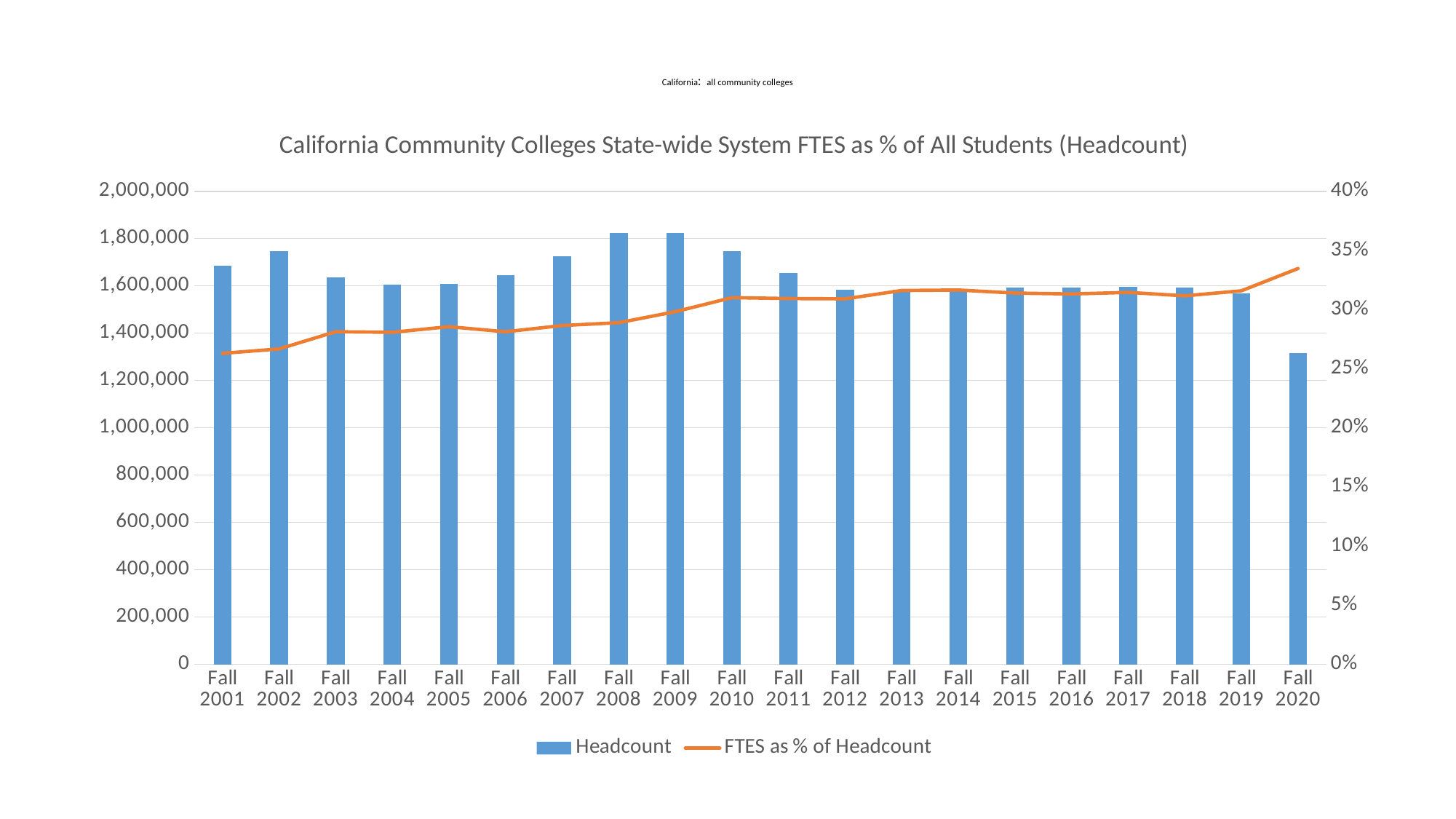
Is the Headcount for Fall 2020 greater or less than 1,400,000? less Is FTES as % of Headcount for Fall 2020 greater or less than 30%? greater Which has the larger Headcount, Fall 2002 or Fall 2003? Fall 2002 In which fall term is FTES as % of Headcount highest? Fall 2020 What kind of chart is this? Combination bar and line chart How many series does the legend list? 2 Which fall term has the lowest Headcount? Fall 2020 Does FTES as % of Headcount generally rise or fall from Fall 2001 to Fall 2020? rise What is the title of the chart? California Community Colleges State-wide System FTES as % of All Students (Headcount) How many fall terms are shown on the x axis of the chart? 20 Is FTES as % of Headcount for Fall 2001 greater or less than 30%? less